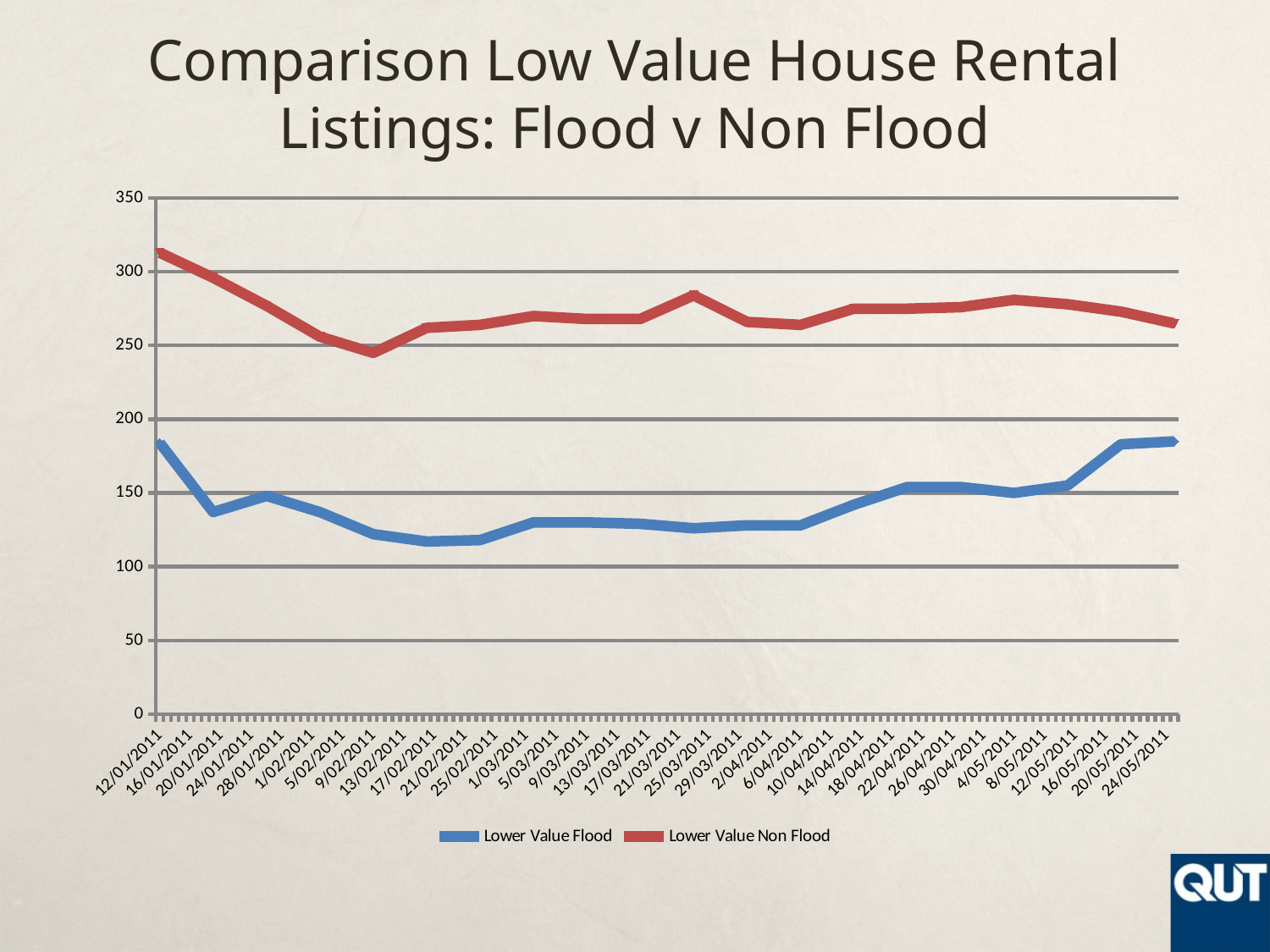
What is the title of the chart? Comparison Low Value House Rental Listings: Flood v Non Flood On 12/01/2011, which series has the larger value, Lower Value Flood or Lower Value Non Flood? Lower Value Non Flood Is the value for Lower Value Flood on 24/05/2011 greater or less than 150? greater Does the Lower Value Non Flood series rise or fall between 12/01/2011 and 9/02/2011? Fall On which date does the Lower Value Non Flood series reach its highest value? 12/01/2011 What kind of chart is shown on the slide? Line chart How many series does the legend list? 2 Is the value for Lower Value Flood on 12/01/2011 greater or less than 150? greater Is the value for Lower Value Non Flood on 12/01/2011 greater or less than 300? greater Which colour is used for the Lower Value Non Flood series? Red